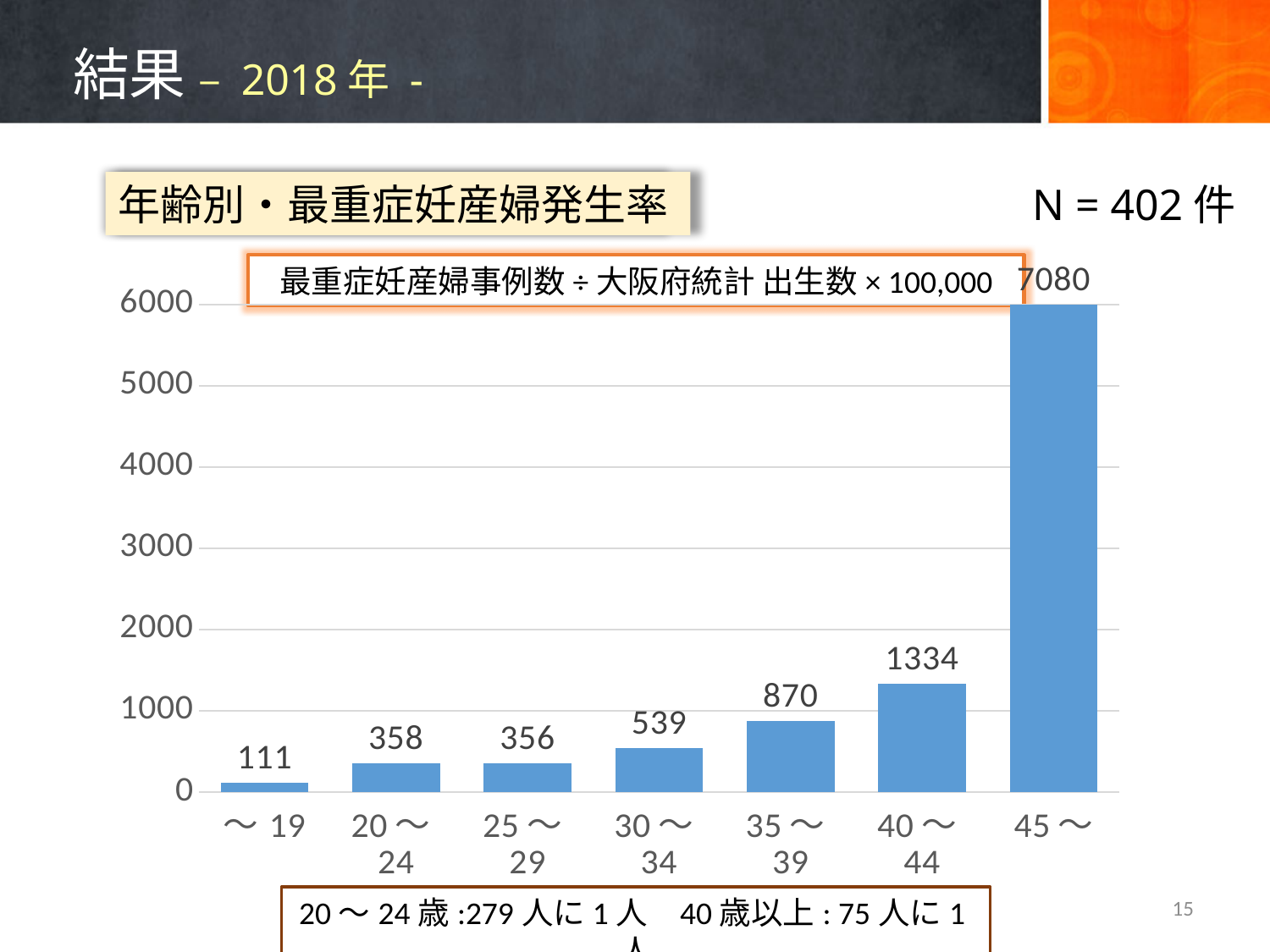
What is the value for the 45～ age group? 7080 Which age group has the highest value? 45～ What is the value for the 30～34 age group? 539 What kind of chart is shown on the slide? bar chart Which is larger, the value for 35～39 or the value for 30～34? 35～39 What is the difference between the values for 40～44 and 35～39? 464 Is the value for 40～44 greater or less than 1000? greater What is the title of the chart? 年齢別・最重症妊産婦発生率 What is the difference between the values for 45～ and 40～44? 5746 How many age groups are shown on the x axis? 7 What is the value for the ～19 age group? 111 Which age group has the lowest value? ～19